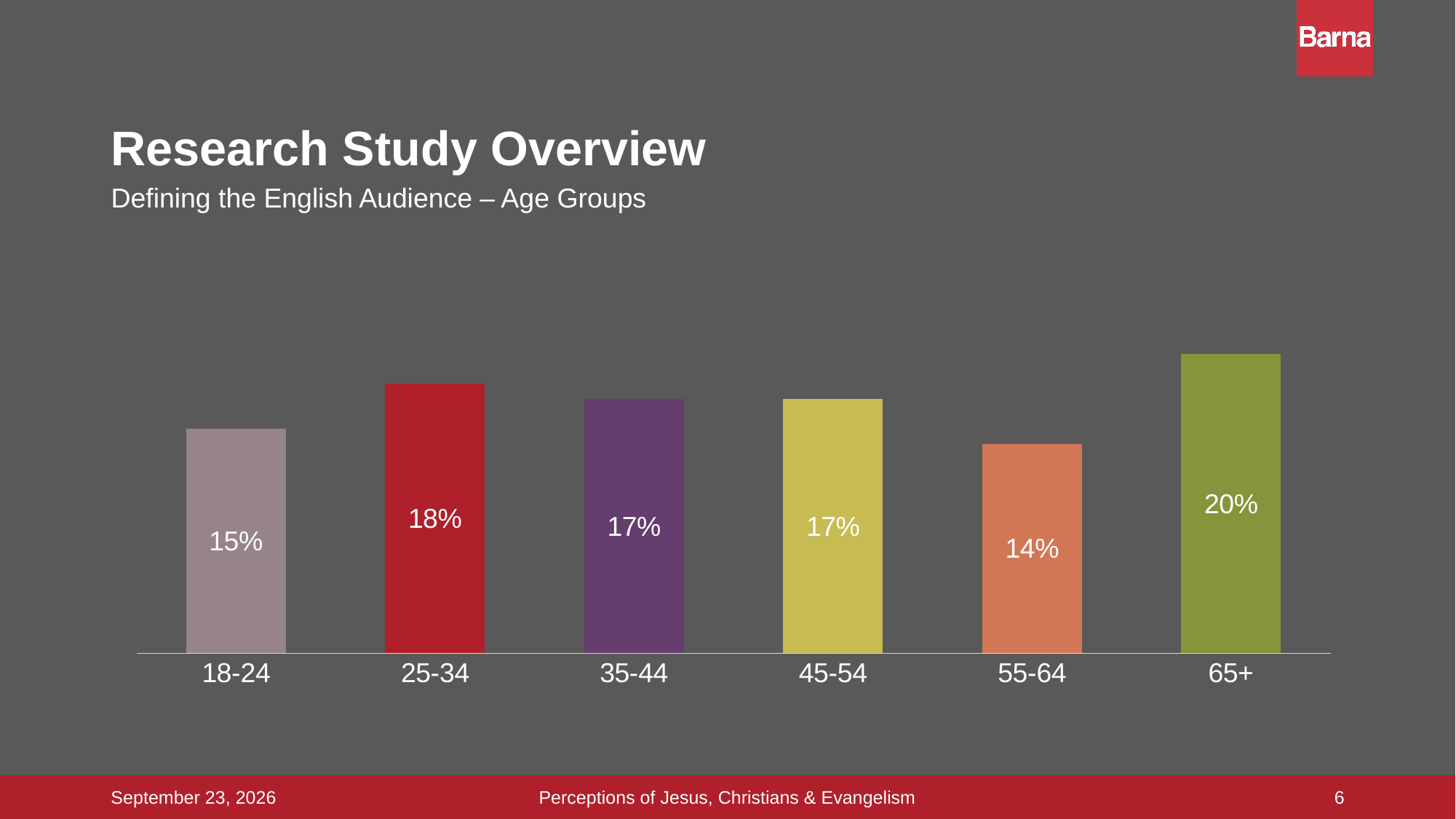
Which is larger, the value for 25-34 or the value for 35-44? 25-34 What is the value for the 65+ age group? 20% What is the difference between the values for 65+ and 55-64? 6% What kind of chart is shown on the slide? Bar chart How many age groups are shown in the chart? 6 Which age group has the highest value? 65+ What is the value for the 18-24 age group? 15% What is the value for the 55-64 age group? 14% What is the value for the 25-34 age group? 18% What is the difference between the values for 25-34 and 18-24? 3% Which age group has the lowest value? 55-64 What is the subtitle of the slide above the chart? Defining the English Audience – Age Groups